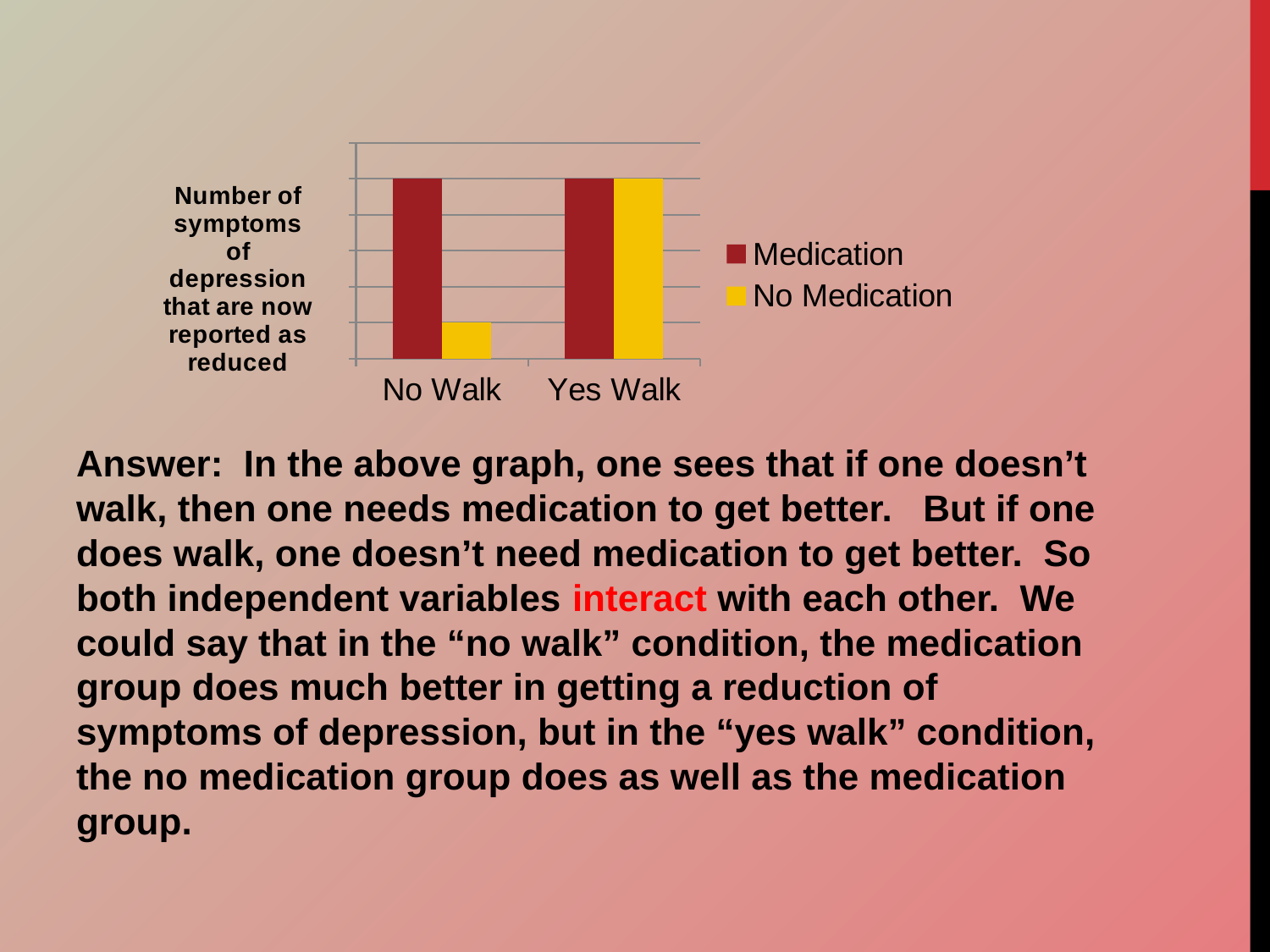
In the No Walk condition, which series has the larger value, Medication or No Medication? Medication What are the two categories on the x axis of the chart? No Walk and Yes Walk What are the two series listed in the chart's legend? Medication and No Medication For the No Medication series, which condition has the larger value, No Walk or Yes Walk? Yes Walk How many categories are shown on the x axis of the chart? 2 Which bar in the chart is the lowest? No Medication in the No Walk condition How many series does the chart's legend list? 2 Which series is shown in yellow in the chart? No Medication Does the No Medication series rise or fall from No Walk to Yes Walk? rise What kind of chart is shown on the slide? bar chart